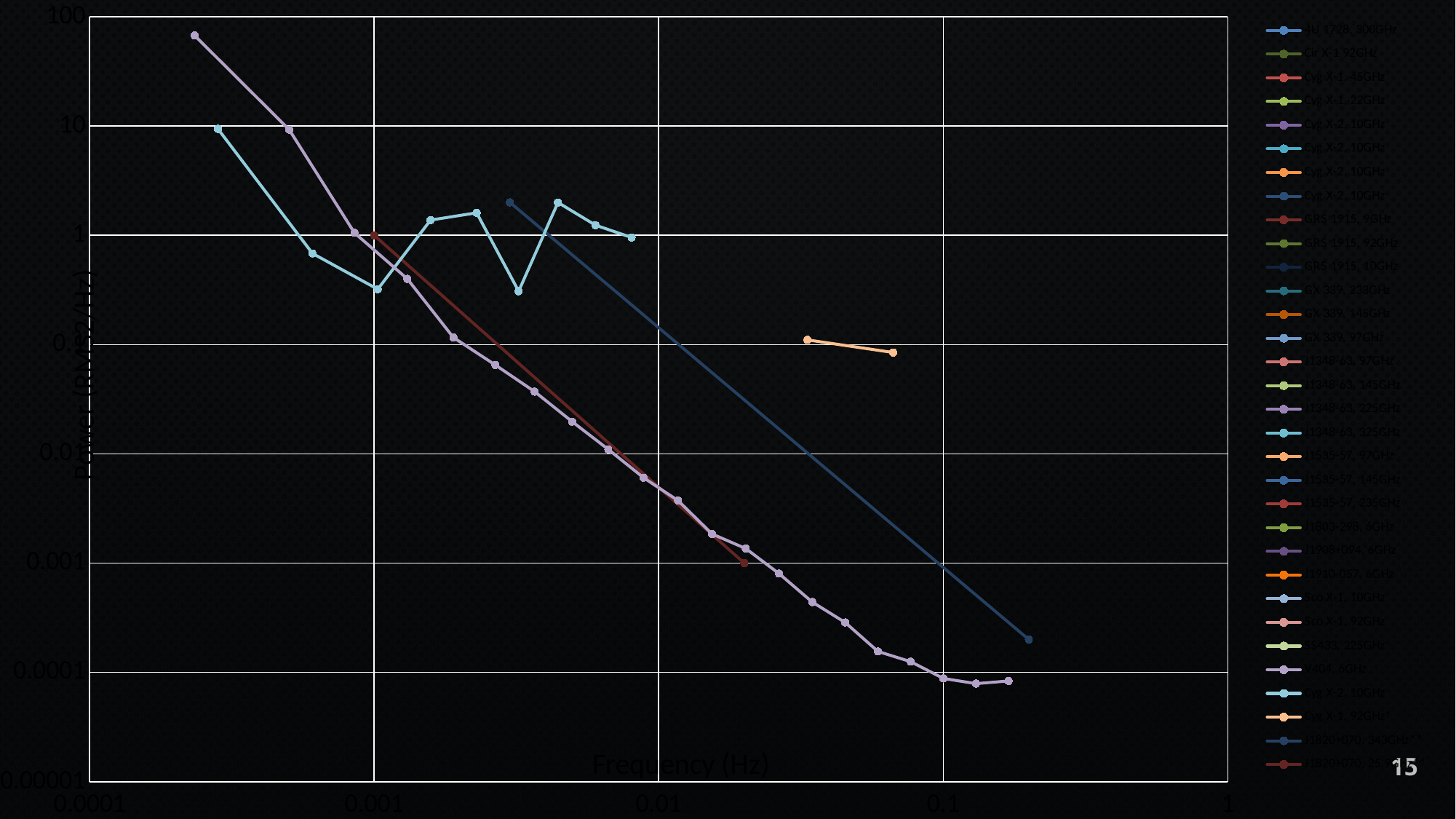
Which line reaches a higher value at its leftmost point, the purple line or the light blue line? the purple line Is the rightmost point of the purple line, near 0.2 Hz, greater or less than 0.001? less Is the rightmost point of the straight dark blue line, near 0.2 Hz, greater or less than 0.001? less Do the values of the straight dark blue line rise or fall as frequency increases along the x axis? fall Is the leftmost point of the purple line greater or less than 10? greater Do the values of the long purple line rise or fall as frequency increases along the x axis? fall What is the largest value shown on the y axis? 100 What kind of chart is shown on the slide? line chart What is the label of the x axis? Frequency (Hz)